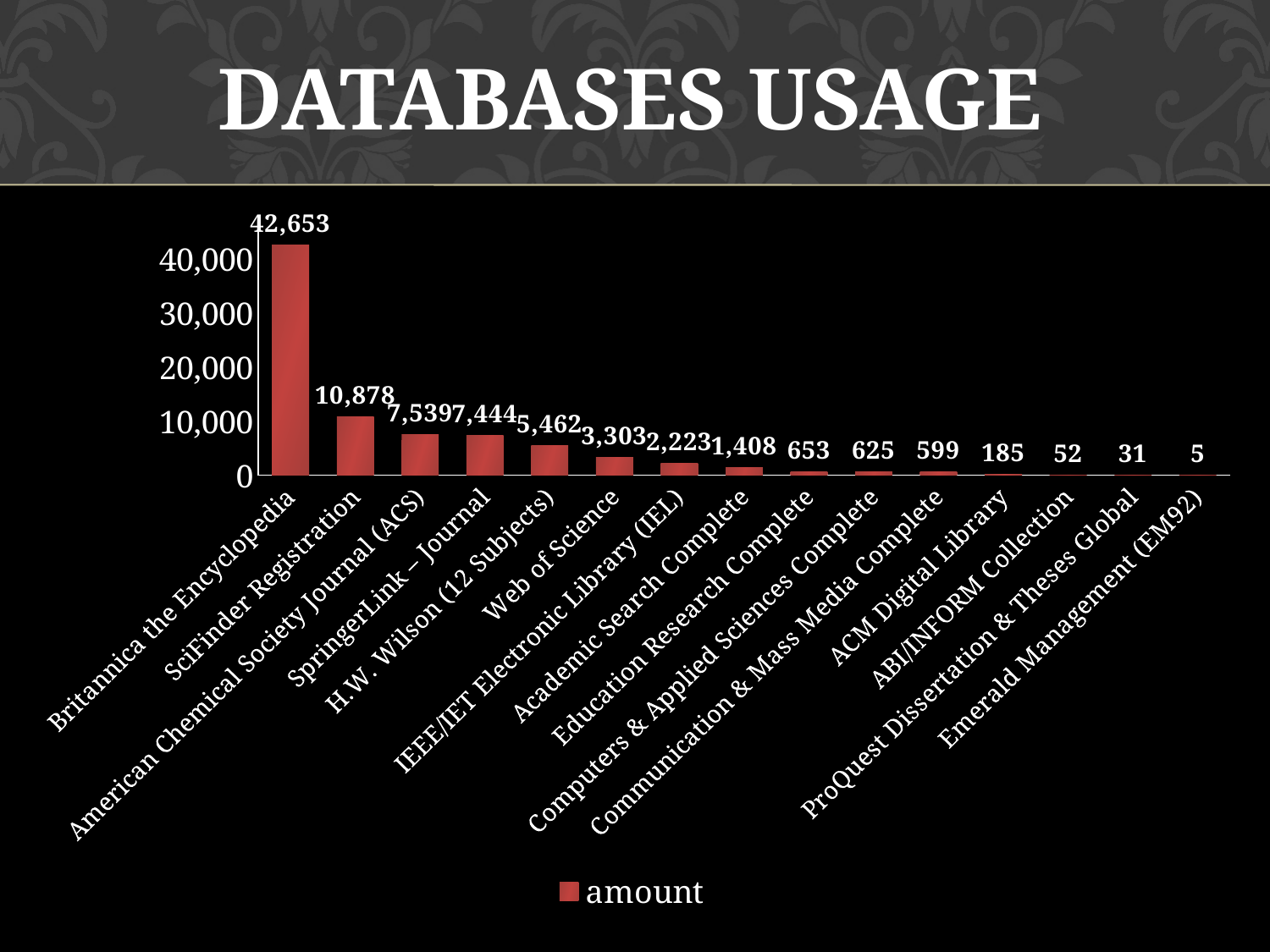
What is the difference between the amounts for Britannica the Encyclopedia and SciFinder Registration? 31,775 Which has a larger amount, H.W. Wilson (12 Subjects) or IEEE/IET Electronic Library (IEL)? H.W. Wilson (12 Subjects) What type of chart is shown on the slide? Bar chart How many databases are shown in the chart? 15 Which database has the highest amount? Britannica the Encyclopedia Which database has the lowest amount? Emerald Management (EM92) What is the amount for SciFinder Registration? 10,878 What is the difference between the amounts for Education Research Complete and Computers & Applied Sciences Complete? 28 What is the amount for Britannica the Encyclopedia? 42,653 What is the amount for Web of Science? 3,303 What series name is listed in the chart legend? amount What is the amount for ACM Digital Library? 185